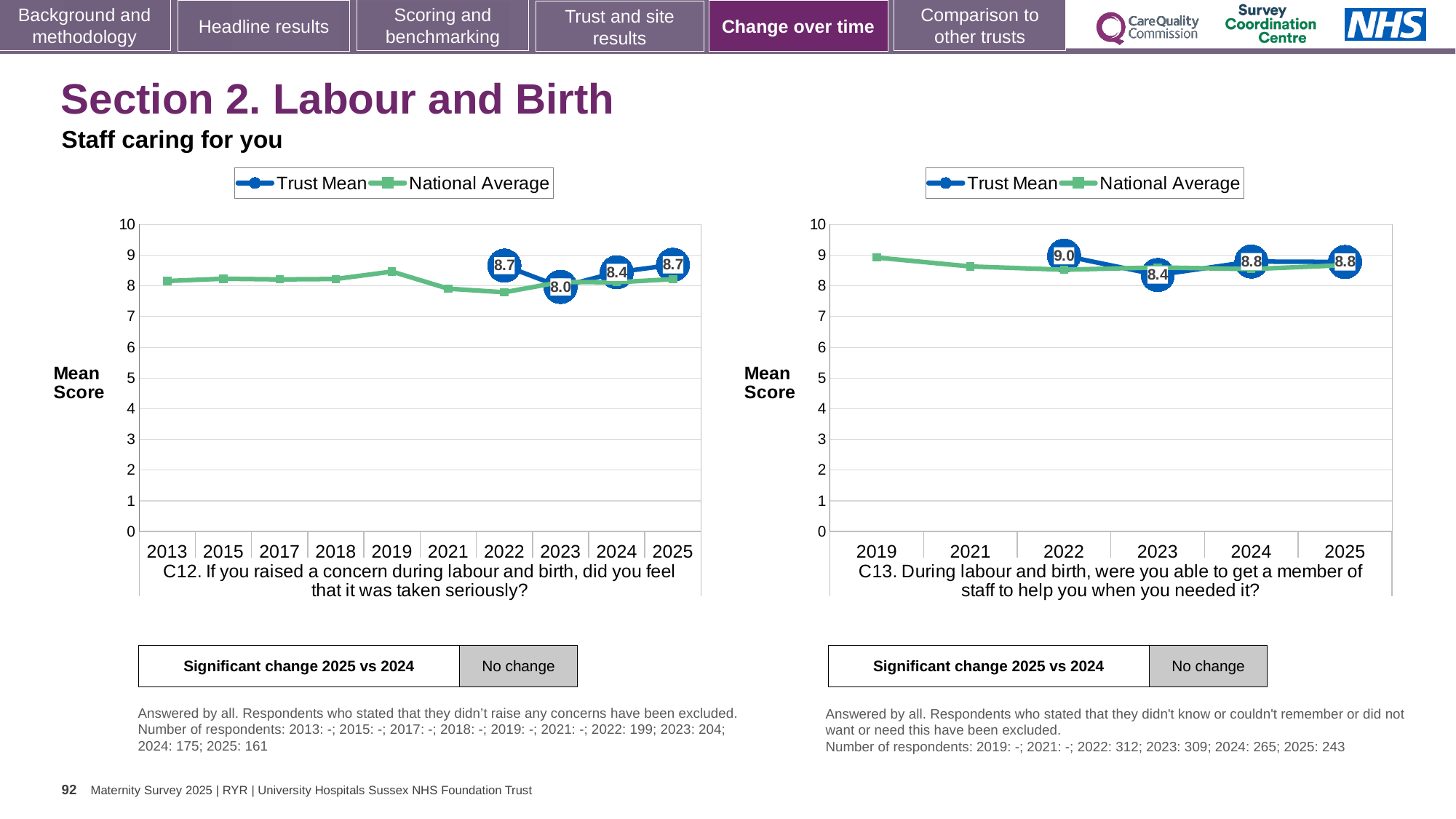
On the C13 chart (right), which year has the highest labelled Trust Mean? 2022 On the C12 chart (left), which year has the lowest labelled Trust Mean? 2023 On the C13 chart (right), what is the difference between the Trust Mean in 2022 and in 2023? 0.6 What type of chart is used on the C12 chart (left)? Line chart On the C13 chart (right), is the Trust Mean higher in 2022 or in 2023? 2022 On the C12 chart (left), how many years are shown on the x axis? 10 On the C13 chart (right), how many series does the legend list? 2 On the C13 chart (right), what is the Trust Mean for 2022? 9.0 On the C12 chart (left), what is the Trust Mean for 2023? 8.0 On the C12 chart (left), what is the difference between the Trust Mean in 2025 and in 2023? 0.7 On the C12 chart (left), what is the Trust Mean for 2025? 8.7 On the C13 chart (right), what is the Trust Mean for 2024? 8.8